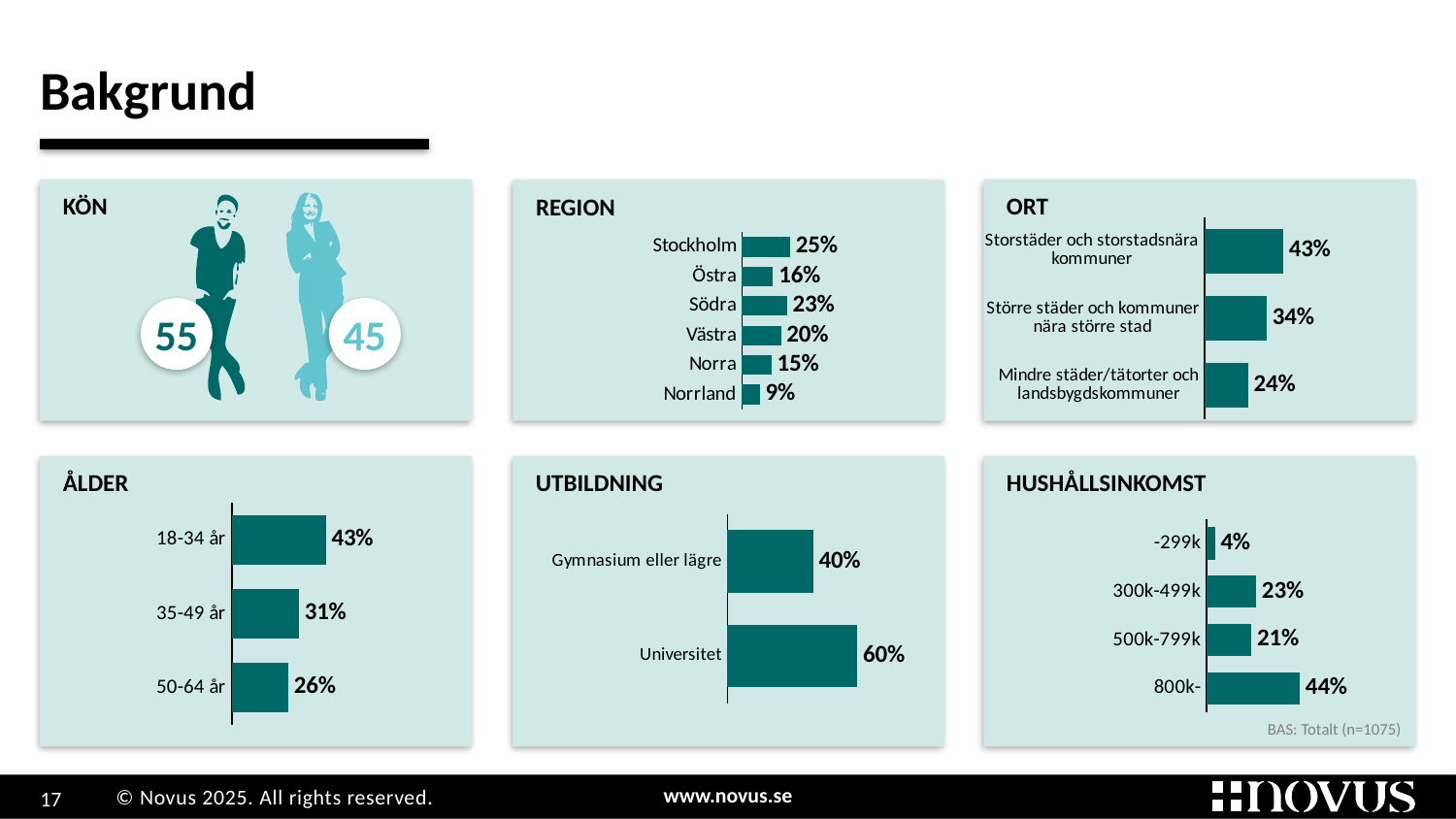
In the REGION chart, how many regions are shown? 6 In the UTBILDNING chart, which is larger, Gymnasium eller lägre or Universitet? Universitet In the ORT chart, what is the value for Större städer och kommuner nära större stad? 34% In the ÅLDER chart, do the values rise or fall from 18-34 år to 50-64 år? fall In the ORT chart, which category has the highest value? Storstäder och storstadsnära kommuner In the ÅLDER chart, what is the value for 35-49 år? 31% In the REGION chart, what is the value for Stockholm? 25% In the REGION chart, what is the difference between Stockholm and Norra? 10% In the HUSHÅLLSINKOMST chart, what is the value for -299k? 4% In the REGION chart, which region has the lowest value? Norrland In the UTBILDNING chart, what is the difference between Universitet and Gymnasium eller lägre? 20% What kind of chart is the HUSHÅLLSINKOMST chart? bar chart